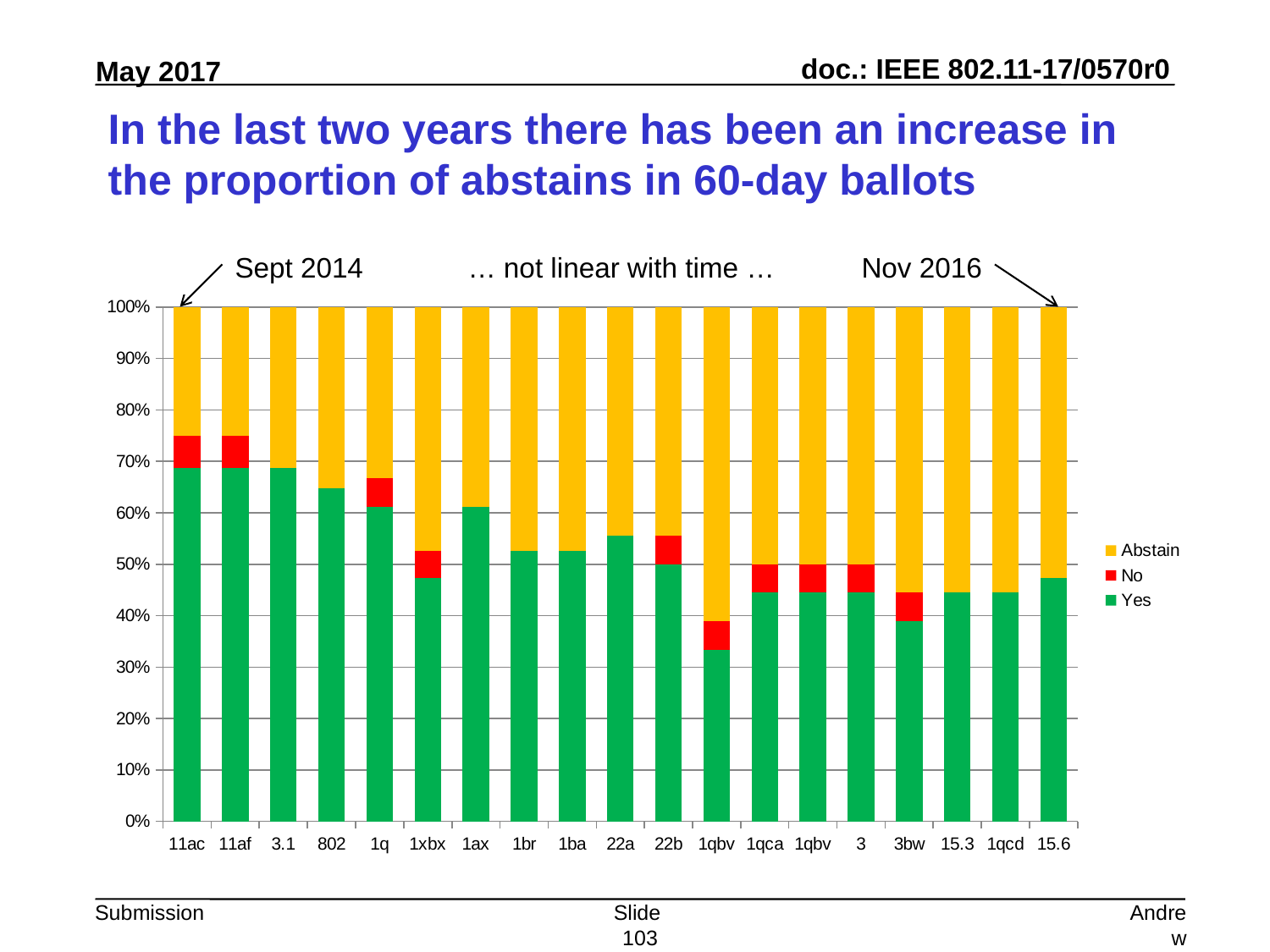
Which ballot has the lowest Yes share? 1qbv Is the Yes share for 11ac greater or less than 60%? greater How many ballots (bars) are plotted on the x axis? 19 Is the Yes share for 1xbx greater or less than 50%? less Is the Yes share for 15.6 greater or less than 50%? less Which colour represents Abstain in the legend? Yellow Which date annotation points to the last bar (15.6)? Nov 2016 How many series does the legend list? 3 Which ballot has the largest Abstain share? 1qbv What kind of chart is shown on the slide? Stacked bar chart Which has the larger Yes share, 1ax or 1br? 1ax